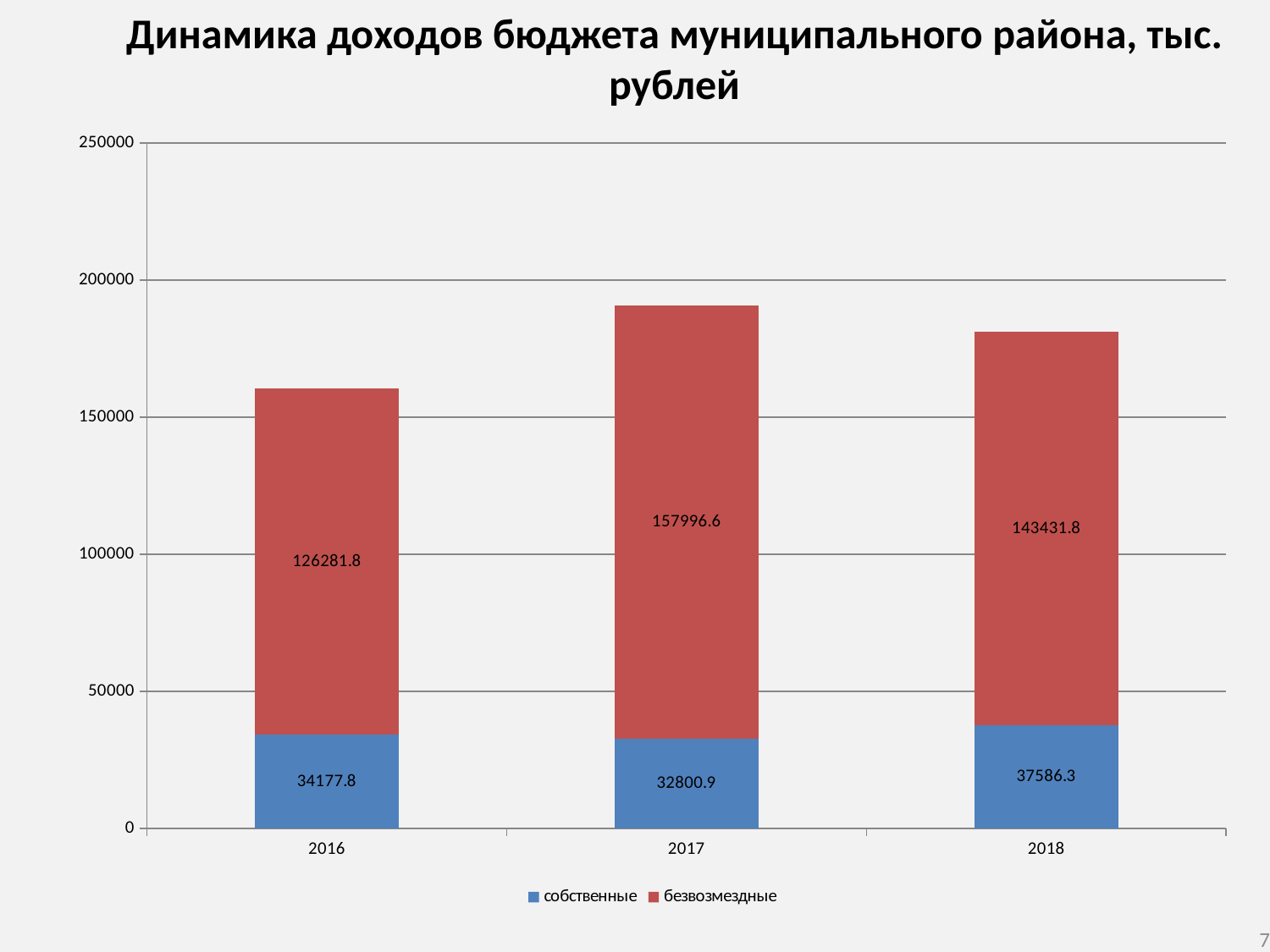
What type of chart is shown on the slide? Stacked bar chart Which colour represents the series безвозмездные? Red What is the value of безвозмездные for 2018? 143431.8 How many years are shown on the x axis? 3 Which is larger: собственные in 2018 or собственные in 2016? 2018 What is the value of безвозмездные for 2016? 126281.8 What is the difference between безвозмездные in 2017 and in 2016? 31714.8 In which year is the value of безвозмездные the highest? 2017 What is the total of the stacked bar for 2016? 160459.6 In which year is the value of собственные the lowest? 2017 What is the value of собственные for 2017? 32800.9 How many series does the legend list? 2